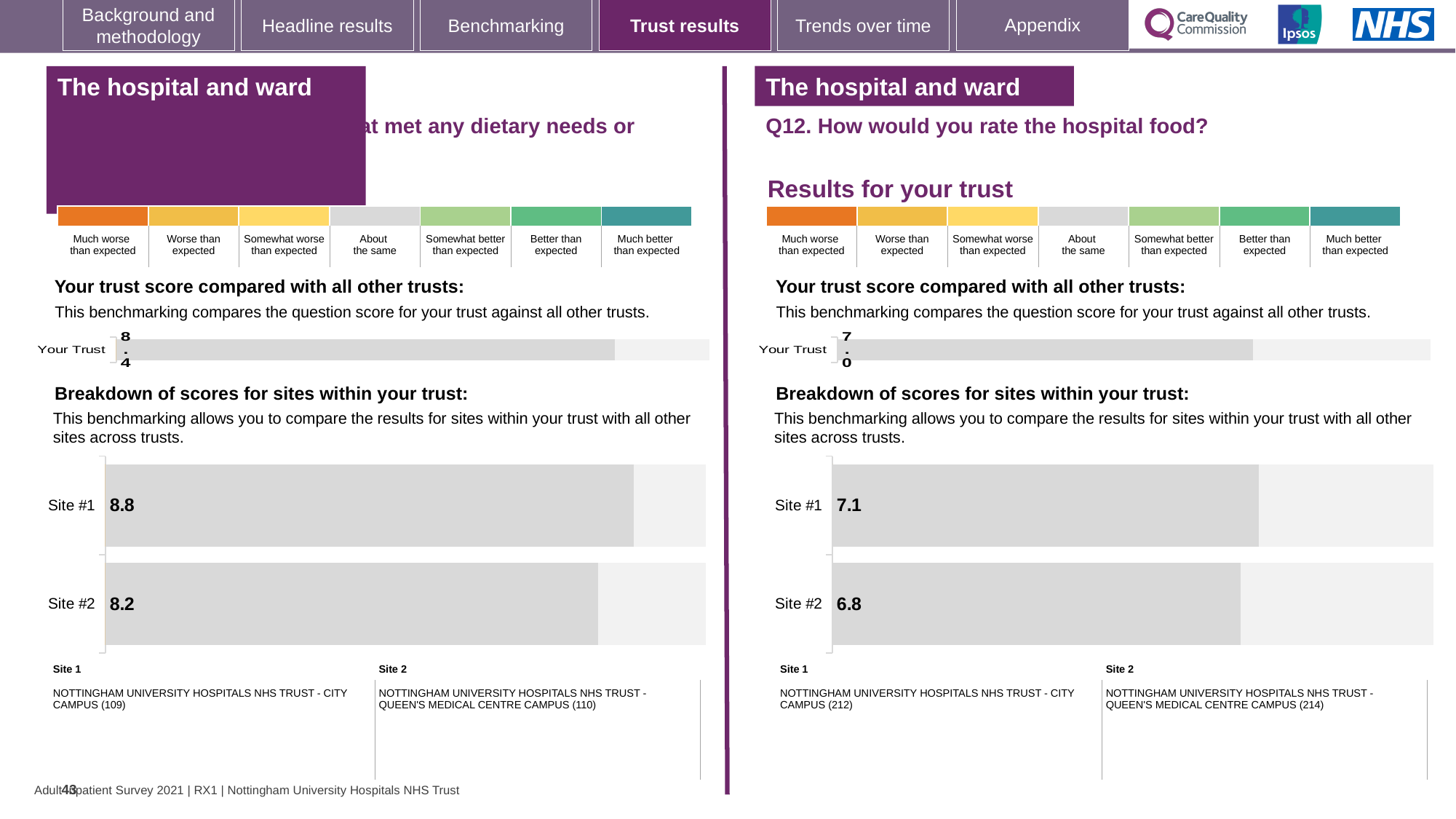
On the left-hand chart (dietary needs question), what is the 'Your Trust' score? 8.4 On the left-hand chart (dietary needs question), what is the score for Site #1? 8.8 On the right-hand chart (Q12, hospital food), what is the score for Site #2? 6.8 On the right-hand chart (Q12, hospital food), what is the 'Your Trust' score? 7.0 On the right-hand chart (Q12, hospital food), what is the score for Site #1? 7.1 On the left-hand chart (dietary needs question), which site has the lower score? Site #2 On the right-hand chart (Q12, hospital food), which site has the higher score? Site #1 On the left-hand chart (dietary needs question), what is the score for Site #2? 8.2 On the right-hand chart (Q12, hospital food), what is the difference between the Site #1 and Site #2 scores? 0.3 What type of chart is used for the site breakdown on the right-hand side (Q12)? Bar chart How many sites are shown in the site breakdown chart on the right-hand side (Q12)? 2 On the left-hand chart (dietary needs question), what is the difference between the Site #1 and Site #2 scores? 0.6